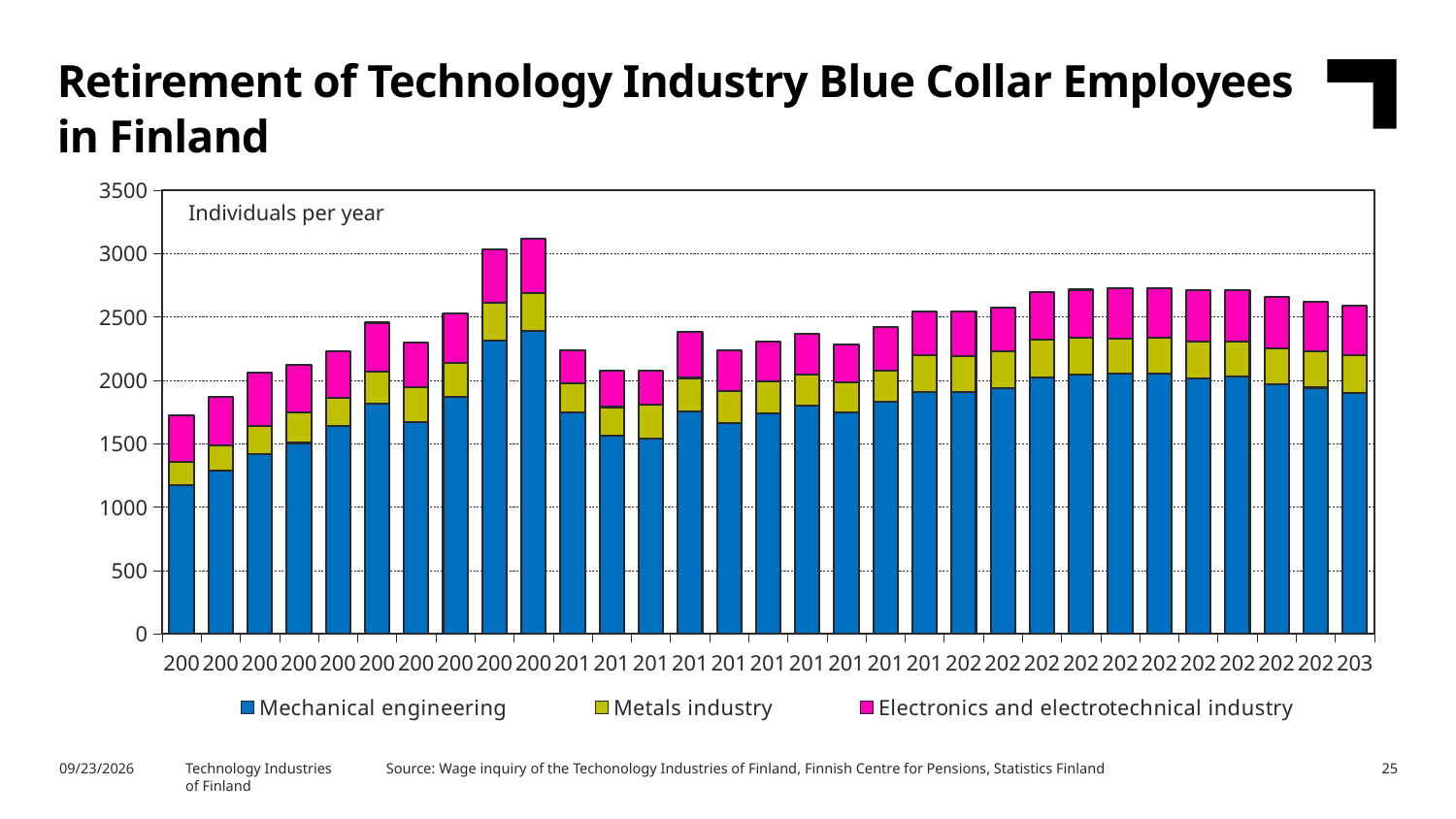
What kind of chart is shown on the slide? Stacked bar chart What unit label is shown inside the plot area? Individuals per year How many bars are plotted in the chart? 31 Is the total of the tallest bar greater or less than 3000? greater Which series makes up the largest part of every bar? Mechanical engineering Which series makes up the smallest part of the leftmost bar? Metals industry What are the three series listed in the legend? Mechanical engineering, Metals industry, Electronics and electrotechnical industry Is the total of the leftmost bar greater or less than 2000? less Is the total of the rightmost bar greater or less than 2500? greater How many series does the legend list? 3 Which bar has the larger total, the leftmost bar or the rightmost bar? The rightmost bar